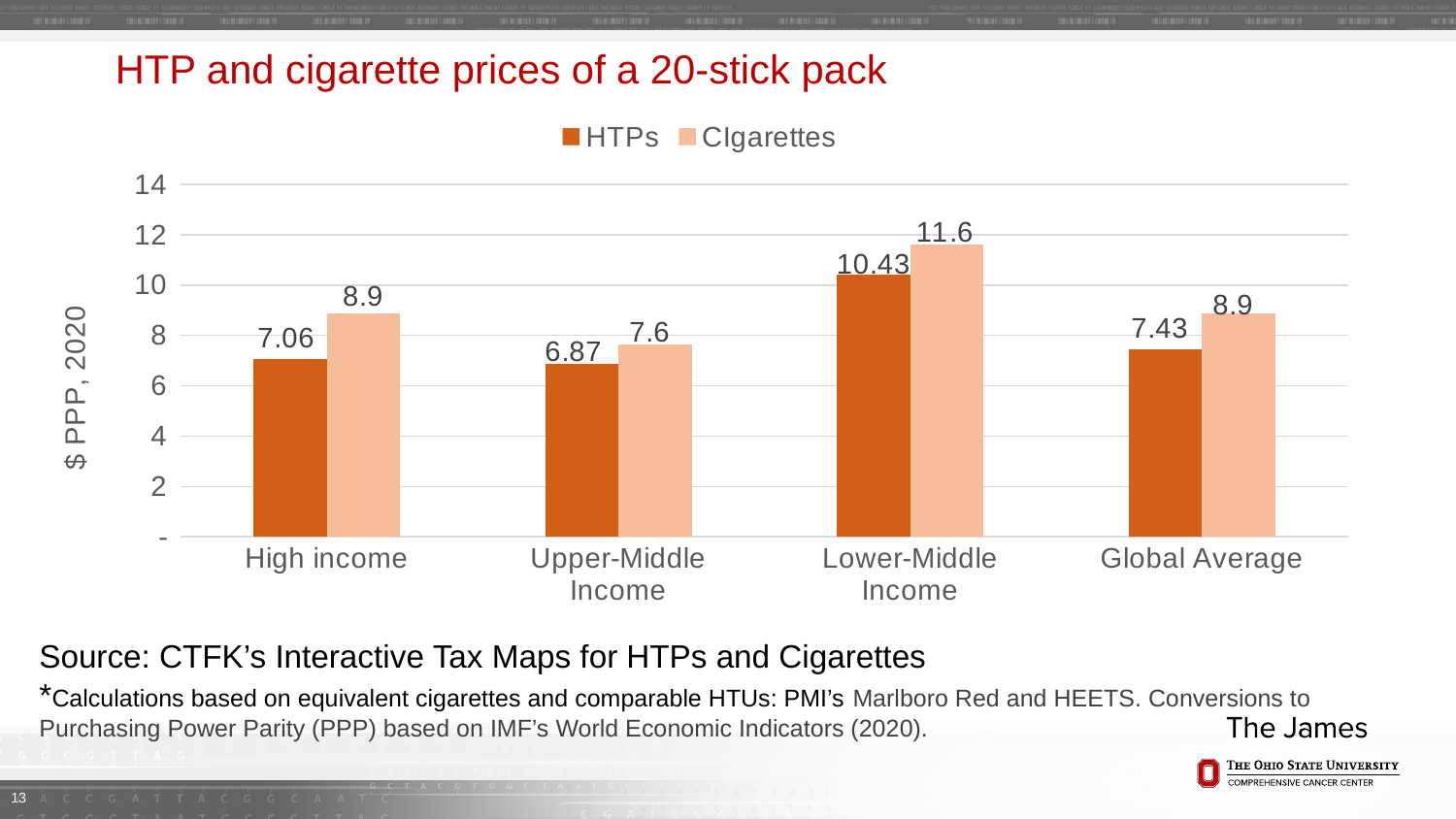
Which is larger for the Upper-Middle Income group, the HTP price or the cigarette price? Cigarettes Is the HTP price for the Lower-Middle Income group greater or less than 10? greater How many income categories are shown on the x axis? 4 What is the cigarette price for the Lower-Middle Income group? 11.6 What is the HTP price for the Global Average? 7.43 Which income group has the lowest HTP price? Upper-Middle Income What is the label of the y axis? $ PPP, 2020 What is the HTP price for the High income group? 7.06 What is the difference between the cigarette price and the HTP price for the Lower-Middle Income group? 1.17 Which income group has the highest cigarette price? Lower-Middle Income How many series does the legend list? 2 What kind of chart is shown on the slide? Bar chart